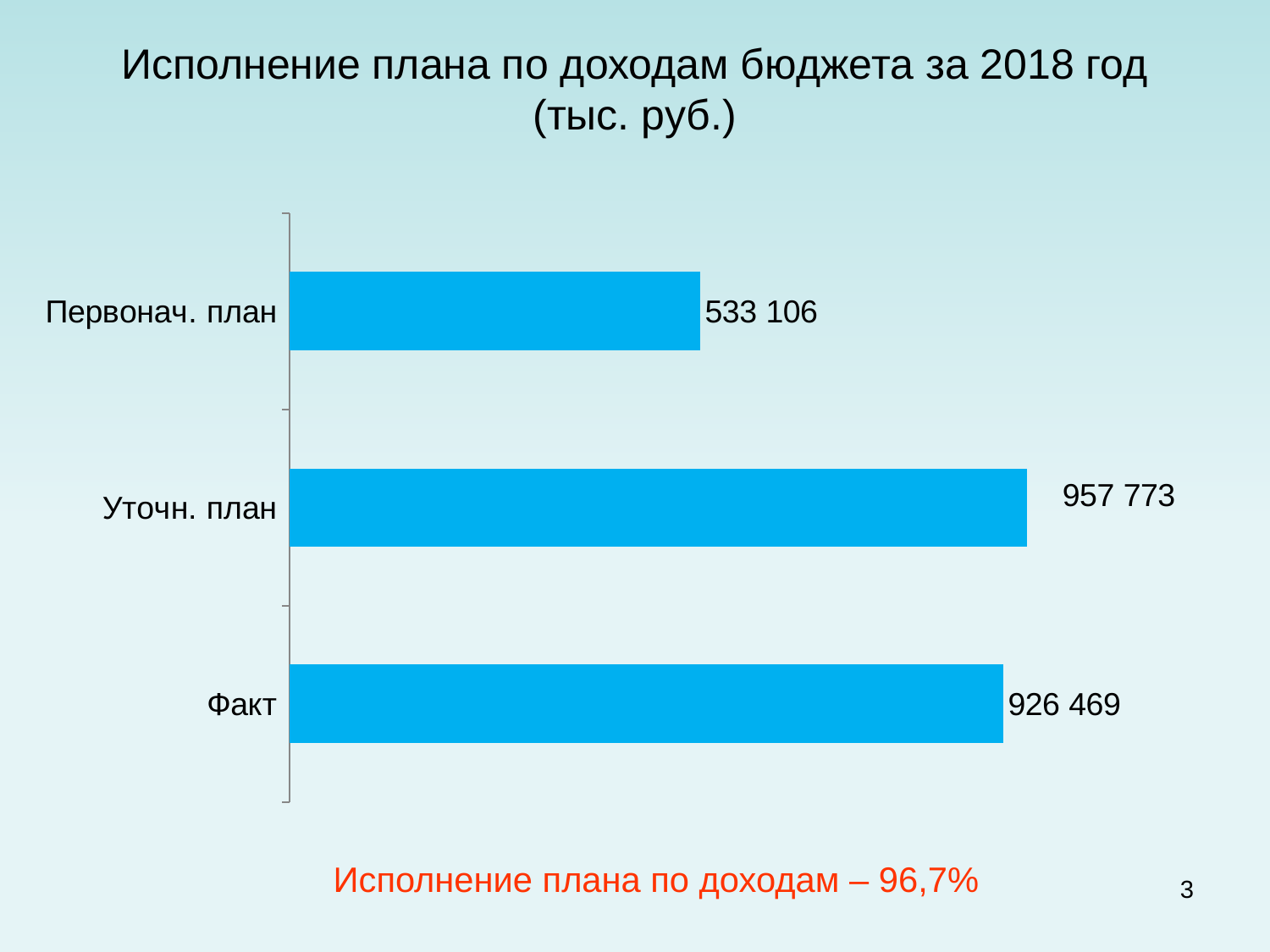
What is the title of the slide containing the chart? Исполнение плана по доходам бюджета за 2018 год (тыс. руб.) Which is larger, Первонач. план or Факт? Факт What is the value for Факт? 926 469 What kind of chart is shown on the slide? bar chart What is the value for Уточн. план? 957 773 What is the difference between Факт and Первонач. план? 393 363 Which category has the highest value? Уточн. план What is the difference between Уточн. план and Факт? 31 304 Which category has the lowest value? Первонач. план Which is larger, Уточн. план or Факт? Уточн. план How many categories are shown in the chart? 3 What is the value for Первонач. план? 533 106